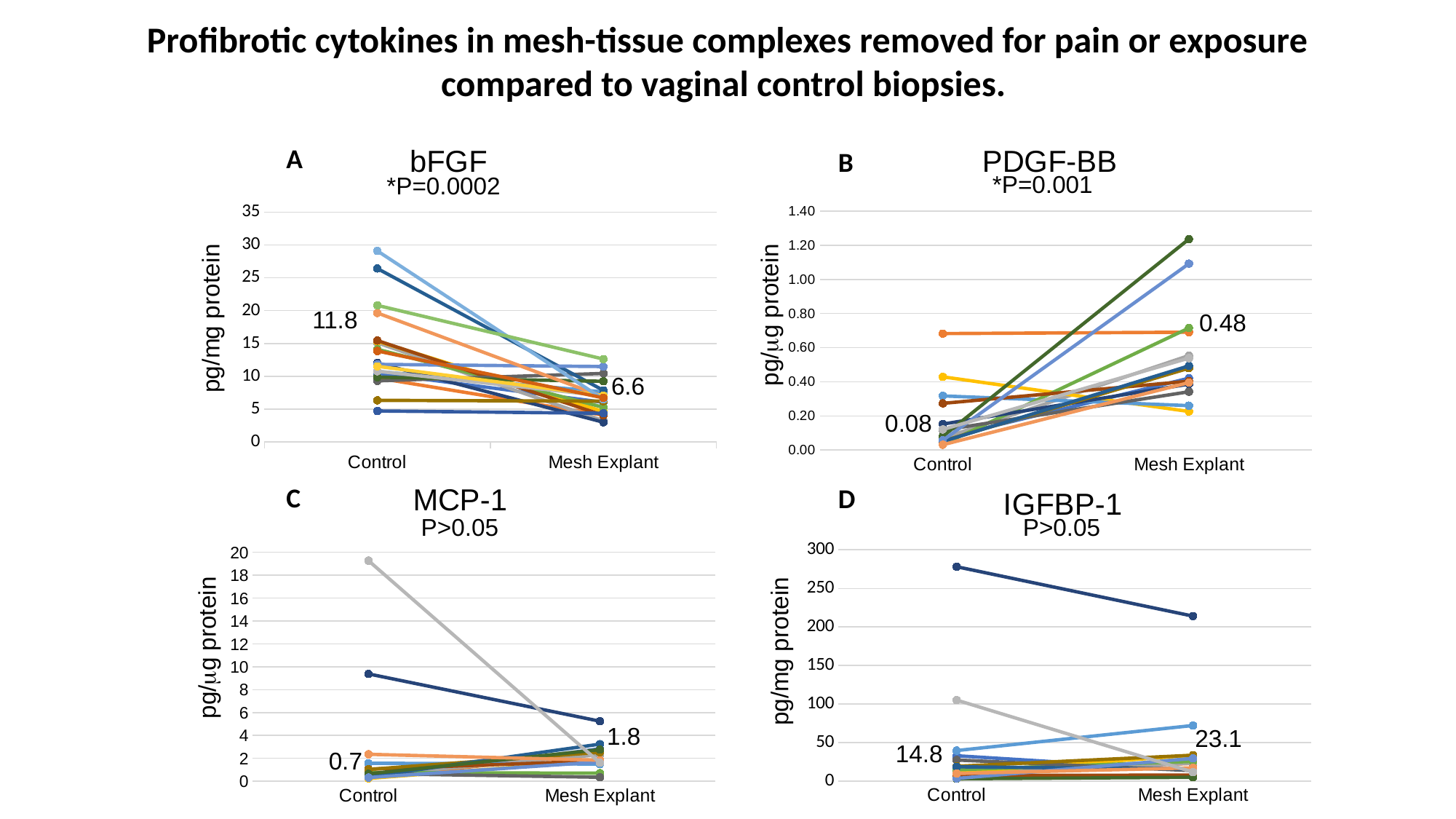
In the IGFBP-1 chart (panel D), is the highest Control point greater or less than 250? greater In the PDGF-BB chart (panel B), what is the difference between the printed Mesh Explant value and the printed Control value? 0.40 In the PDGF-BB chart (panel B), what value is printed next to the Mesh Explant group? 0.48 In the bFGF chart (panel A), what value is printed next to the Mesh Explant group? 6.6 What kind of chart is the bFGF chart (panel A)? line chart In the bFGF chart (panel A), what value is printed next to the Control group? 11.8 What P-value is printed under the PDGF-BB chart title (panel B)? *P=0.001 In the MCP-1 chart (panel C), what is the difference between the printed Mesh Explant value (1.8) and the printed Control value (0.7)? 1.1 In the IGFBP-1 chart (panel D), which printed value is larger, Control or Mesh Explant? Mesh Explant In the bFGF chart (panel A), do the printed summary values rise or fall from Control to Mesh Explant? fall In the MCP-1 chart (panel C), is the highest Control point greater or less than 18? greater How many x-axis categories does the MCP-1 chart (panel C) have? 2